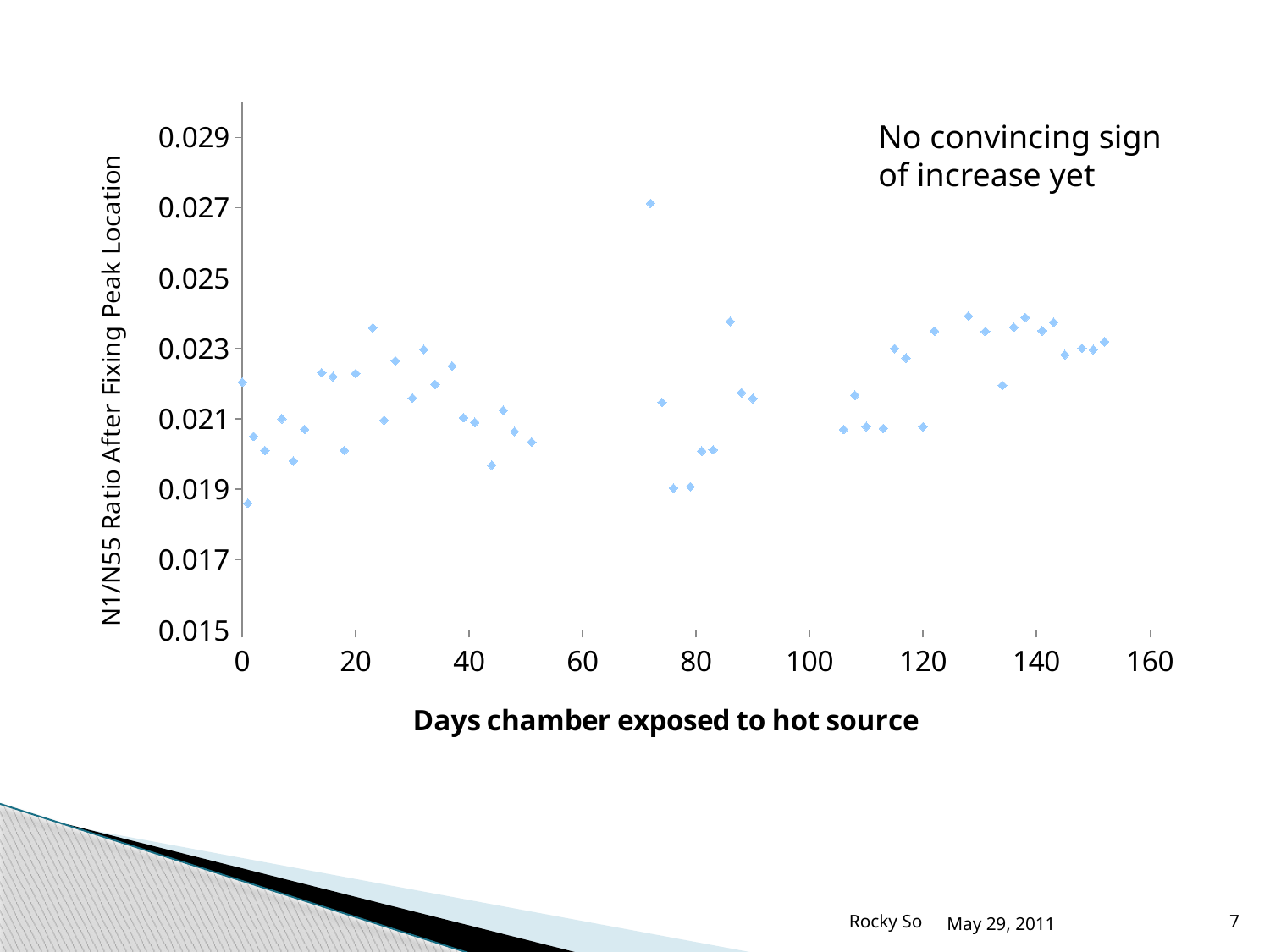
Is the point plotted just after 40 days, the lowest in that cluster, greater or less than 0.021? less Between which two x-axis tick values does the lowest point on the chart lie? 0 and 20 What is the title of the y axis? N1/N55 Ratio After Fixing Peak Location What is the title of the x axis? Days chamber exposed to hot source Between which two x-axis tick values does the highest point on the chart lie? 60 and 80 Is the highest point on the chart greater or less than 0.025? greater According to the annotation on the chart, is there a convincing sign of increase in the ratio over time? No What kind of chart is shown on the slide? Scatter chart What is the maximum value shown on the y axis? 0.029 Are the points plotted between 120 and 140 days mostly greater or less than 0.021? greater